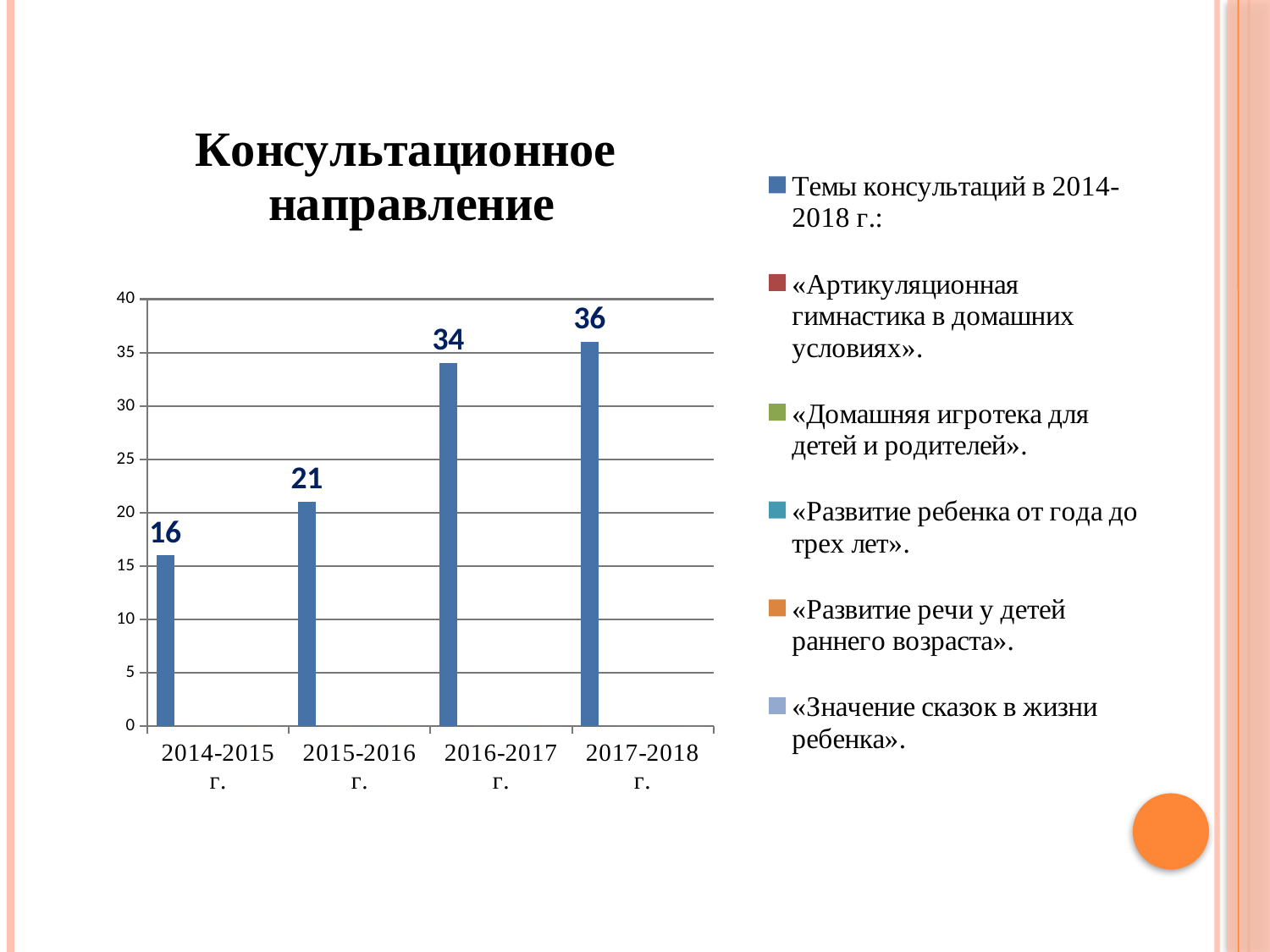
What kind of chart is shown on the slide? Bar chart What is the value for 2014-2015 г.? 16 What is the title of the chart? Консультационное направление What is the value for 2016-2017 г.? 34 What is the difference between the values for 2016-2017 г. and 2015-2016 г.? 13 Do the values rise or fall from 2014-2015 г. to 2017-2018 г.? Rise Which is larger, the value for 2015-2016 г. or the value for 2014-2015 г.? 2015-2016 г. Which period has the lowest value? 2014-2015 г. What is the value for 2017-2018 г.? 36 How many periods are shown on the x axis? 4 What is the value for 2015-2016 г.? 21 Which period has the highest value? 2017-2018 г.